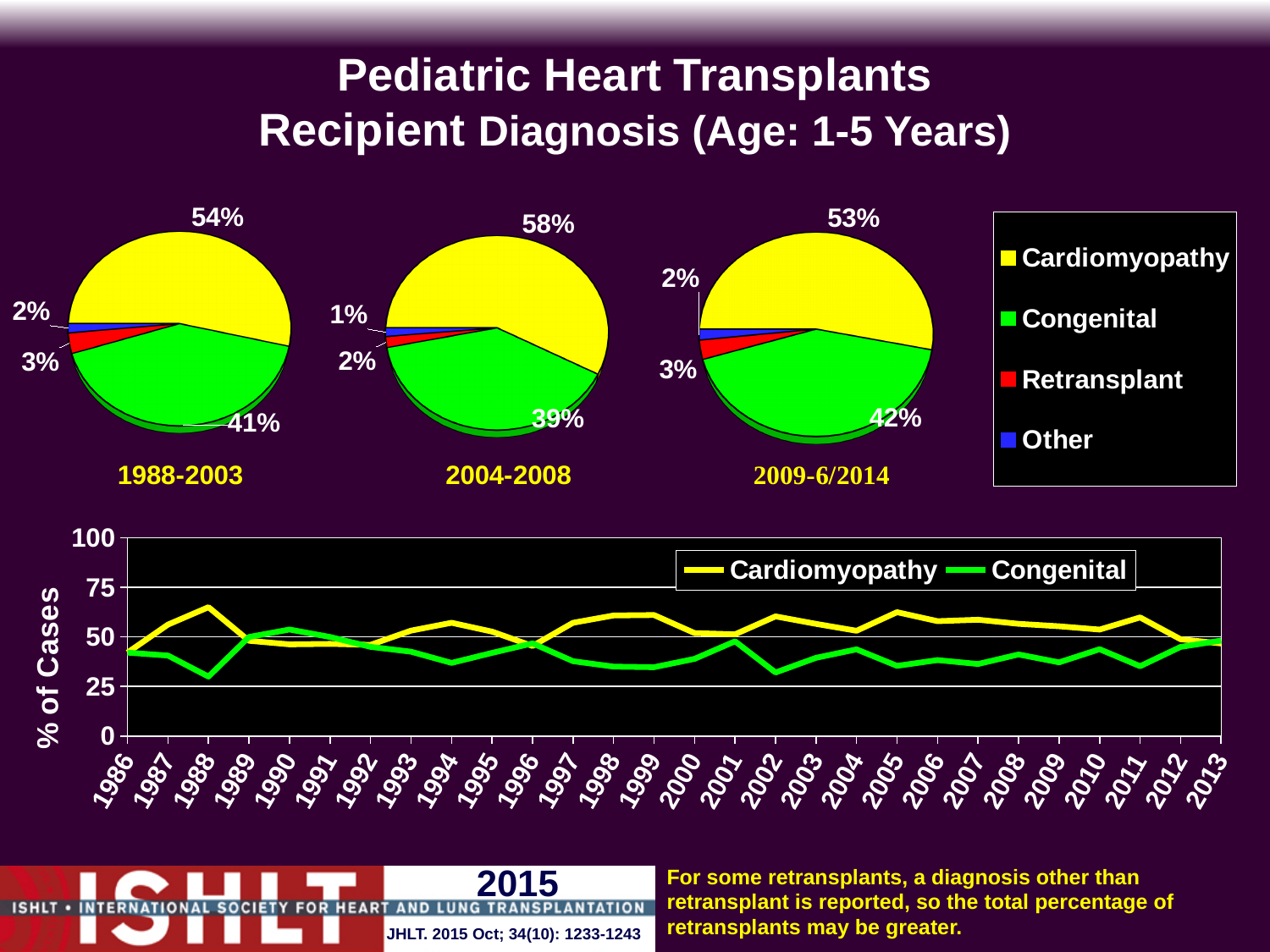
Which pie chart shows the higher Cardiomyopathy share, 2004-2008 or 2009-6/2014? 2004-2008 In the 2004-2008 pie chart, which diagnosis has the smallest share? Other In the 1988-2003 pie chart, what percentage is Cardiomyopathy? 54% In the 2004-2008 pie chart, what percentage is Congenital? 39% How many diagnosis categories does the pie chart legend list? 4 In the 2009-6/2014 pie chart, what percentage is Retransplant? 3% In the bottom line chart, is the Congenital value for 1988 greater or less than 50? less How many series does the legend of the bottom line chart list? 2 In the 2009-6/2014 pie chart, which diagnosis has the largest share? Cardiomyopathy In the bottom line chart, is the Cardiomyopathy value for 2005 greater or less than 50? greater In the 1988-2003 pie chart, what is the difference between the Cardiomyopathy and Congenital shares? 13% What type of chart is the bottom chart showing % of Cases from 1986 to 2013? line chart